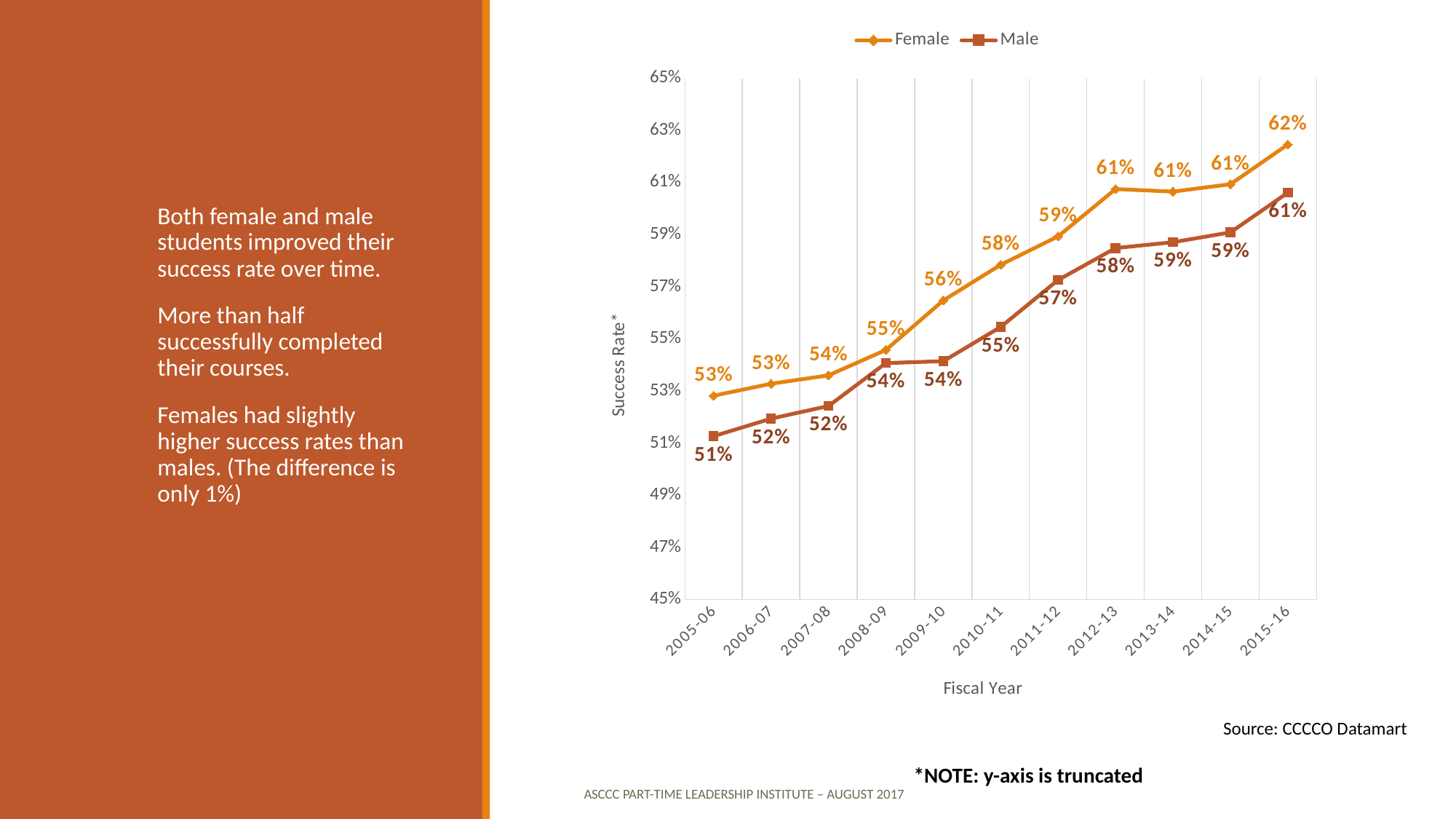
How many series does the legend list? 2 What type of chart is shown on the slide? line chart What is the Female success rate for 2009-10? 56% In which fiscal year is the Male success rate lowest? 2005-06 Does the Male success rate generally rise or fall from 2005-06 to 2015-16? rise How many fiscal years are plotted on the x axis? 11 What is the difference between the Female and Male success rates in 2010-11? 3% Which series has the higher success rate in 2008-09, Female or Male? Female What is the Female success rate for 2015-16? 62% What is the Male success rate for 2005-06? 51% What is the Male success rate for 2011-12? 57% In which fiscal year is the Female success rate highest? 2015-16